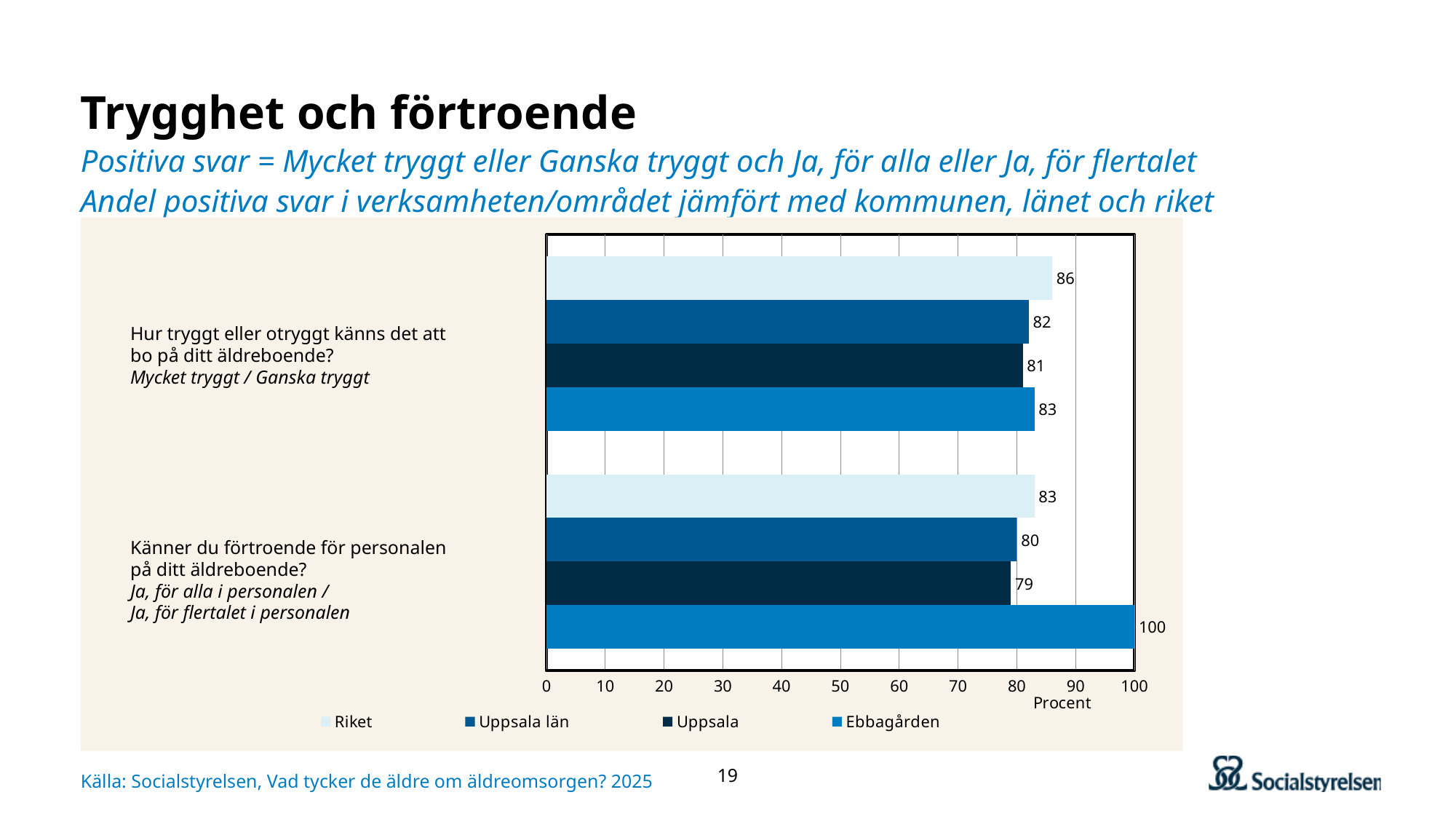
What is the value for Riket on the question "Hur tryggt eller otryggt känns det att bo på ditt äldreboende?"? 86 What is the difference between Riket and Ebbagården on the question "Hur tryggt eller otryggt känns det att bo på ditt äldreboende?"? 3 What is the difference between Ebbagården and Uppsala on the question "Känner du förtroende för personalen på ditt äldreboende?"? 21 Which is larger on the question "Känner du förtroende för personalen på ditt äldreboende?": Riket or Uppsala län? Riket What is the value for Uppsala on the question "Känner du förtroende för personalen på ditt äldreboende?"? 79 Which series has the highest value on the question "Känner du förtroende för personalen på ditt äldreboende?"? Ebbagården What label is shown on the x axis of the chart? Procent How many series does the legend list? 4 Which series has the lowest value on the question "Hur tryggt eller otryggt känns det att bo på ditt äldreboende?"? Uppsala What kind of chart is shown on the slide? bar chart What is the value for Ebbagården on the question "Känner du förtroende för personalen på ditt äldreboende?"? 100 What is the value for Uppsala län on the question "Hur tryggt eller otryggt känns det att bo på ditt äldreboende?"? 82